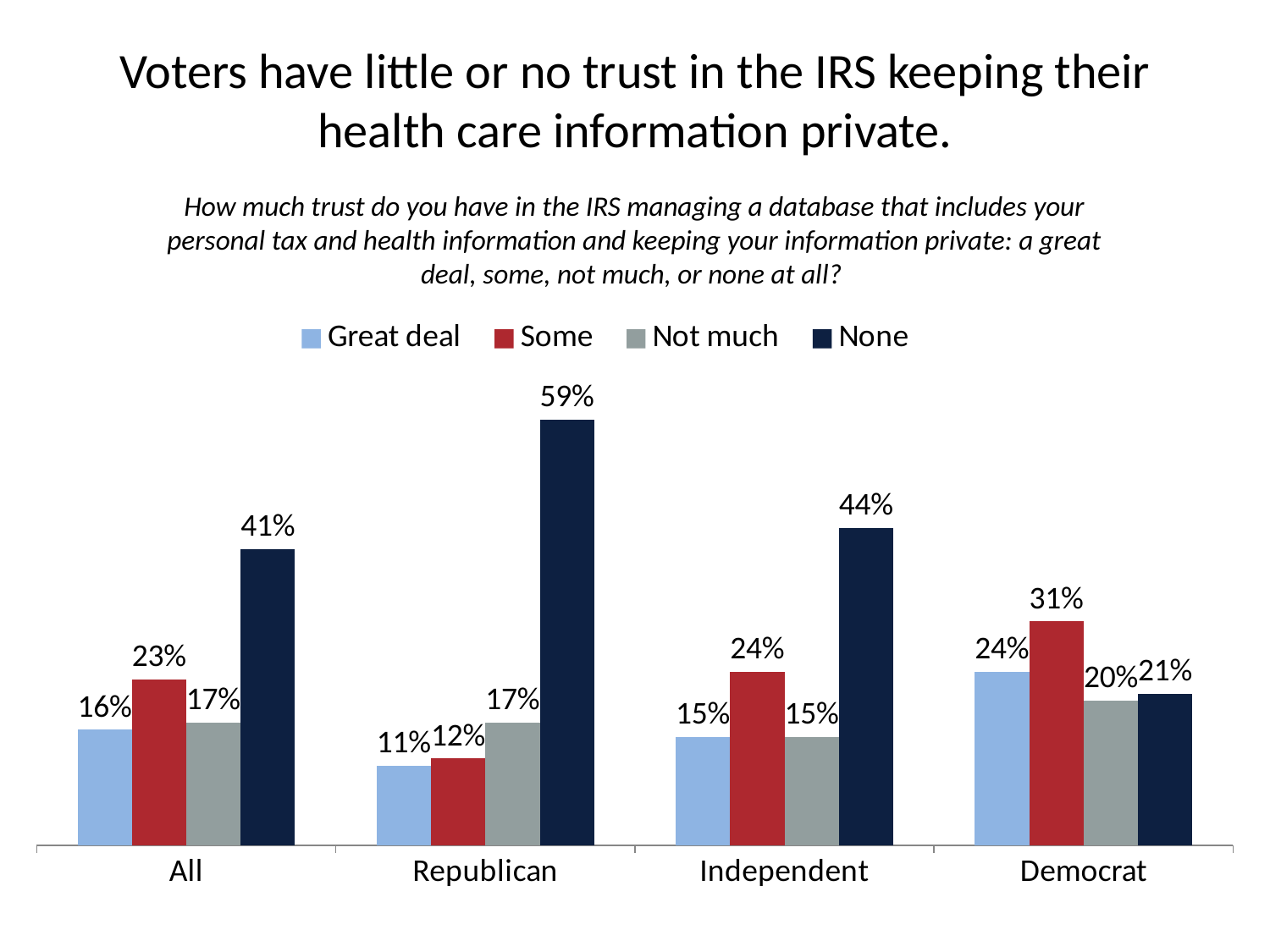
What is the value for 'Some' among Democrat voters? 31% What percentage of Republican voters say they have no trust (None) in the IRS keeping their health care information private? 59% What kind of chart is shown on the slide? Bar chart What is the difference between 'None' and 'Great deal' for All voters? 25 percentage points What is the value for 'Great deal' among All voters? 16% Which group has the highest value for 'None'? Republican Which legend entry is shown in dark navy? None What is the difference between the 'None' values for Republican and Democrat voters? 38 percentage points Which is larger for Independent voters: 'Some' or 'Not much'? Some Which group has the lowest value for 'Great deal'? Republican How many voter groups are shown on the x axis? 4 How many series does the legend list? 4